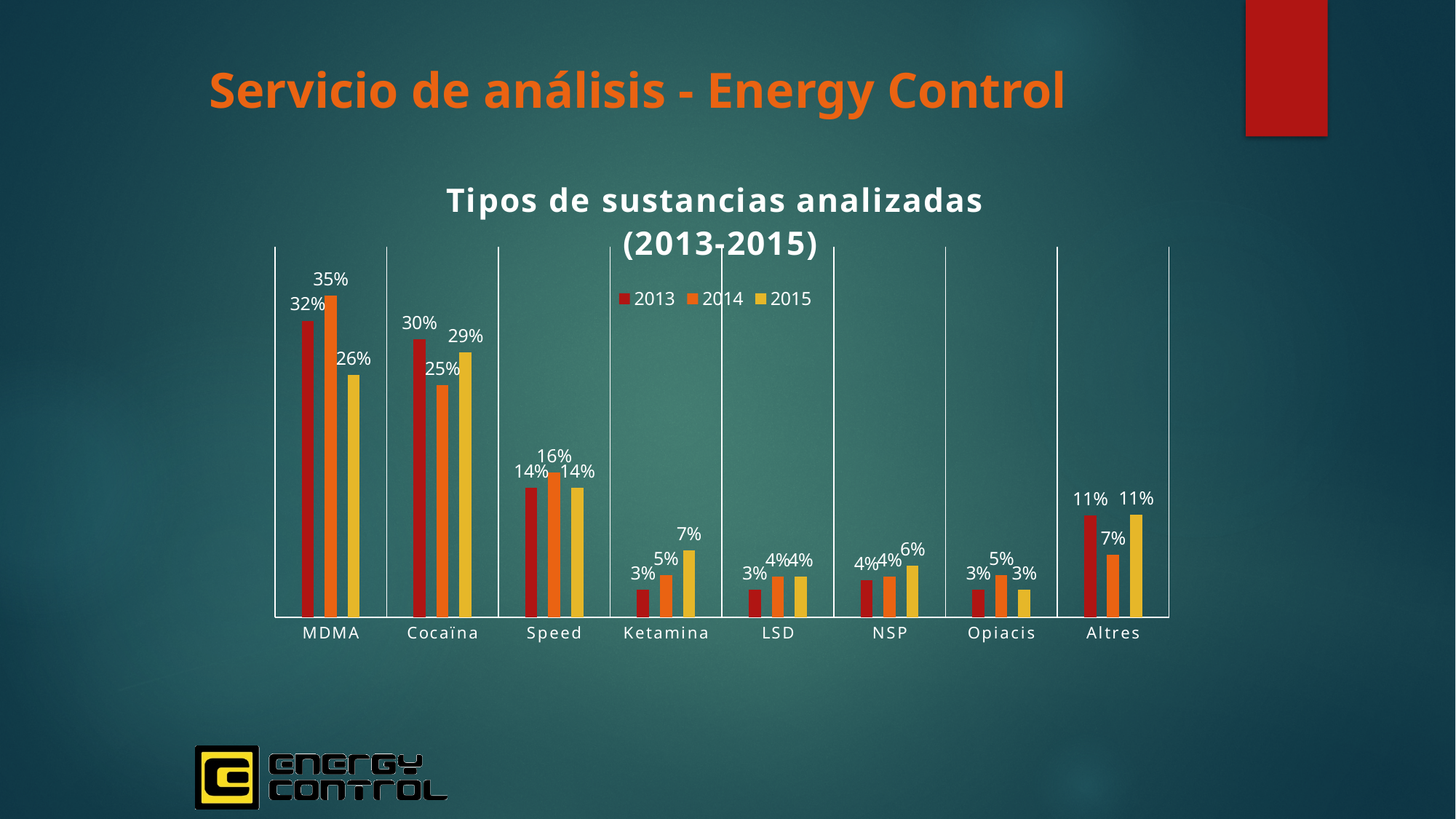
How many series does the legend list? 3 Which is larger for Altres: the 2013 value or the 2014 value? 2013 Do the values for Ketamina rise or fall from 2013 to 2015? Rise What is the value for Ketamina in 2013? 3% What is the value for MDMA in 2014? 35% Which category has the highest value in 2013? MDMA Which category has the lowest value in 2015? Opiacis What is the difference between the 2014 and 2015 values for MDMA? 9% How many categories are shown on the x axis? 8 What kind of chart is shown? Bar chart What is the title of the chart? Tipos de sustancias analizadas (2013-2015) What is the value for Cocaïna in 2015? 29%